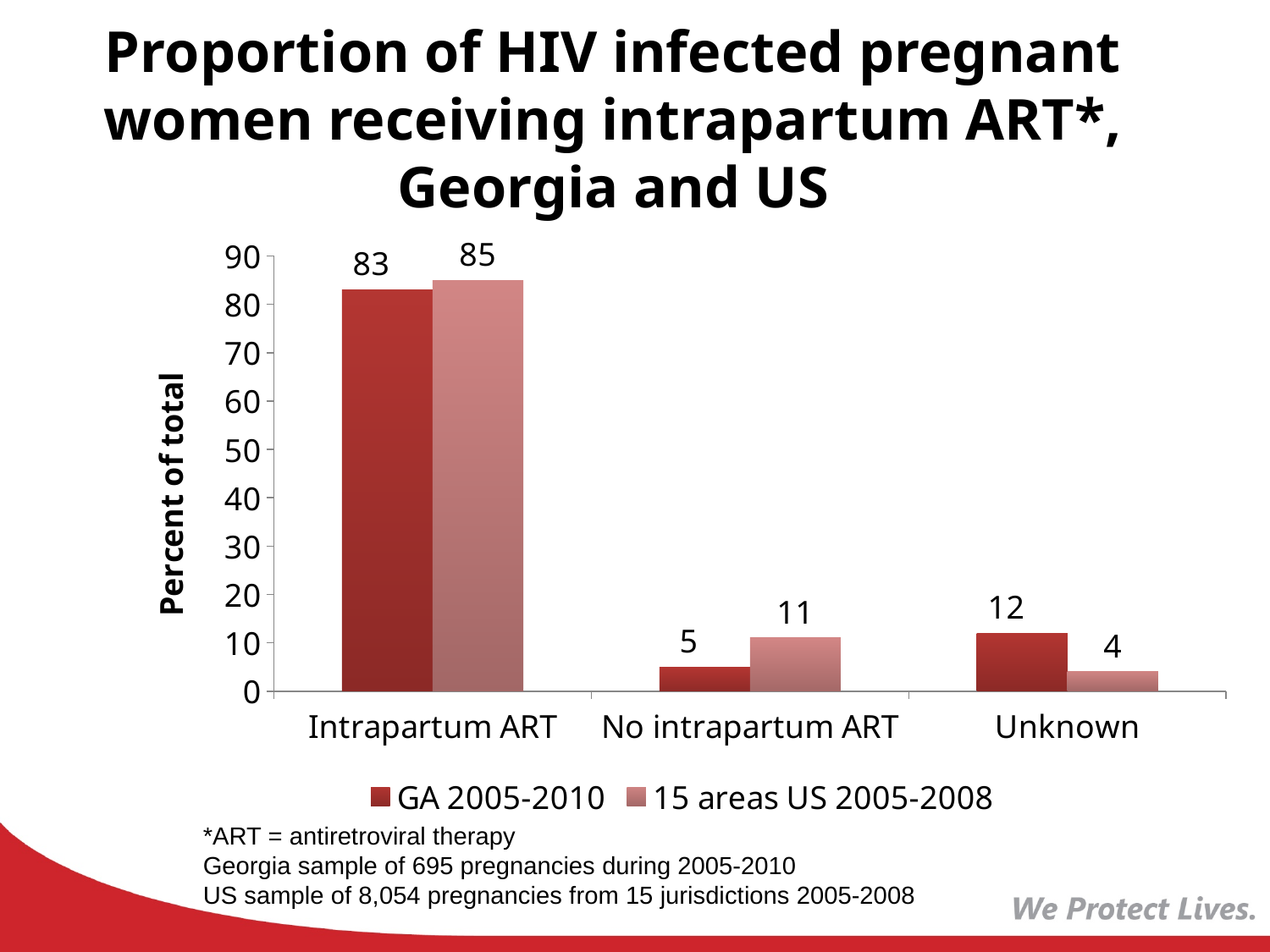
What is the value for GA 2005-2010 in the No intrapartum ART category? 5 Which category has the lowest value for 15 areas US 2005-2008? Unknown What is the label of the y axis? Percent of total How many series does the legend list? 2 What is the value for 15 areas US 2005-2008 in the Unknown category? 4 In the Unknown category, which series has the larger value, GA 2005-2010 or 15 areas US 2005-2008? GA 2005-2010 What kind of chart is shown on the slide? Bar chart What is the difference between the 15 areas US 2005-2008 and GA 2005-2010 values in the No intrapartum ART category? 6 What is the value for 15 areas US 2005-2008 in the Intrapartum ART category? 85 Which category has the highest value for GA 2005-2010? Intrapartum ART What is the value for GA 2005-2010 in the Intrapartum ART category? 83 How many categories are shown on the x axis? 3